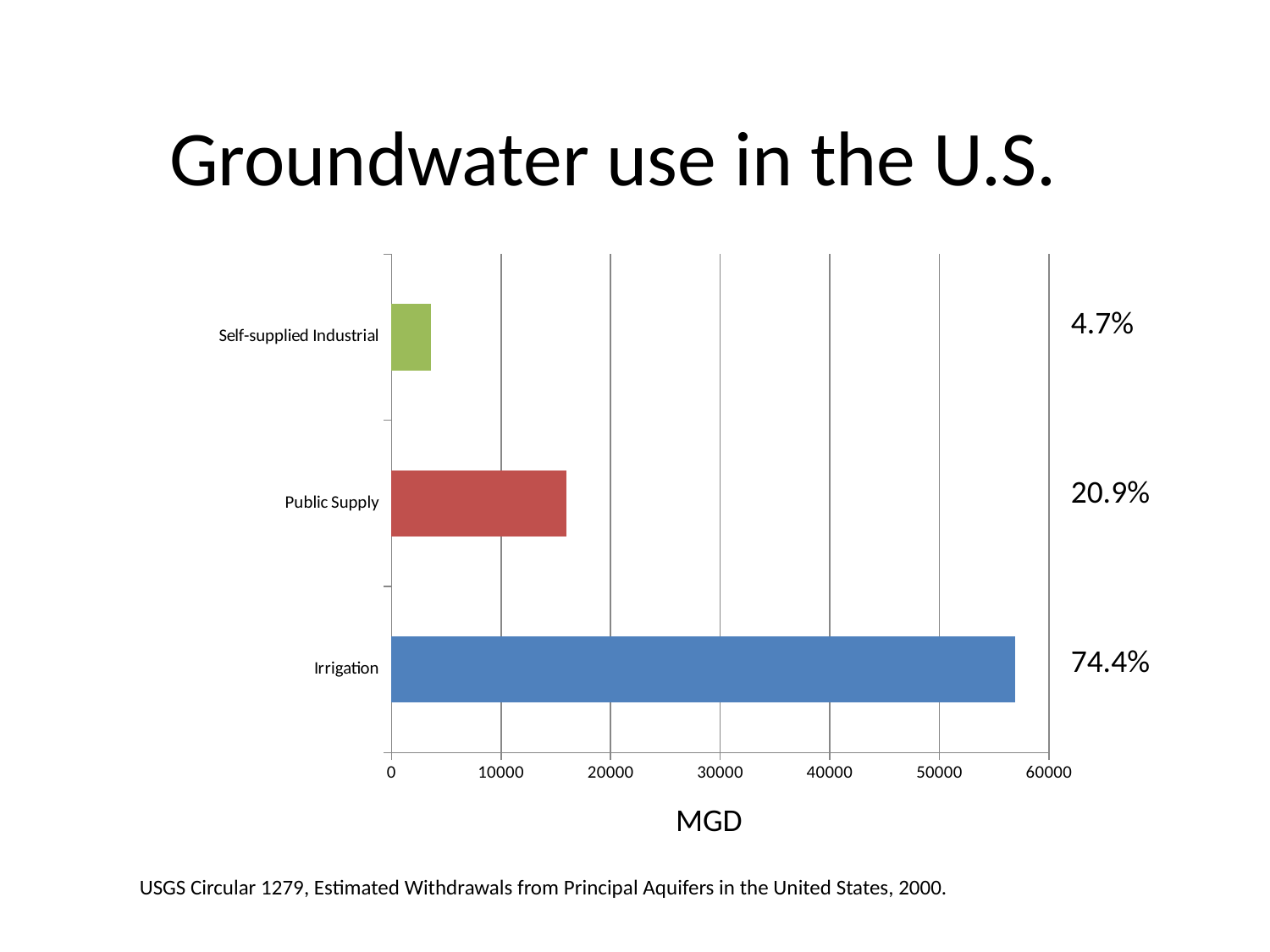
What percentage is shown next to the Self-supplied Industrial bar? 4.7% How many categories are plotted in the chart? 3 What is the label on the horizontal axis of the chart? MGD Is the value for Self-supplied Industrial greater or less than 10000 MGD? less Is the value for Irrigation greater or less than 50000 MGD? greater What kind of chart is shown on the slide? bar chart Which is larger, the value for Public Supply or the value for Self-supplied Industrial? Public Supply Is the value for Public Supply greater or less than 20000 MGD? less Which category has the highest groundwater use? Irrigation What percentage is shown next to the Public Supply bar? 20.9% What percentage is shown next to the Irrigation bar? 74.4% Which category has the lowest groundwater use? Self-supplied Industrial